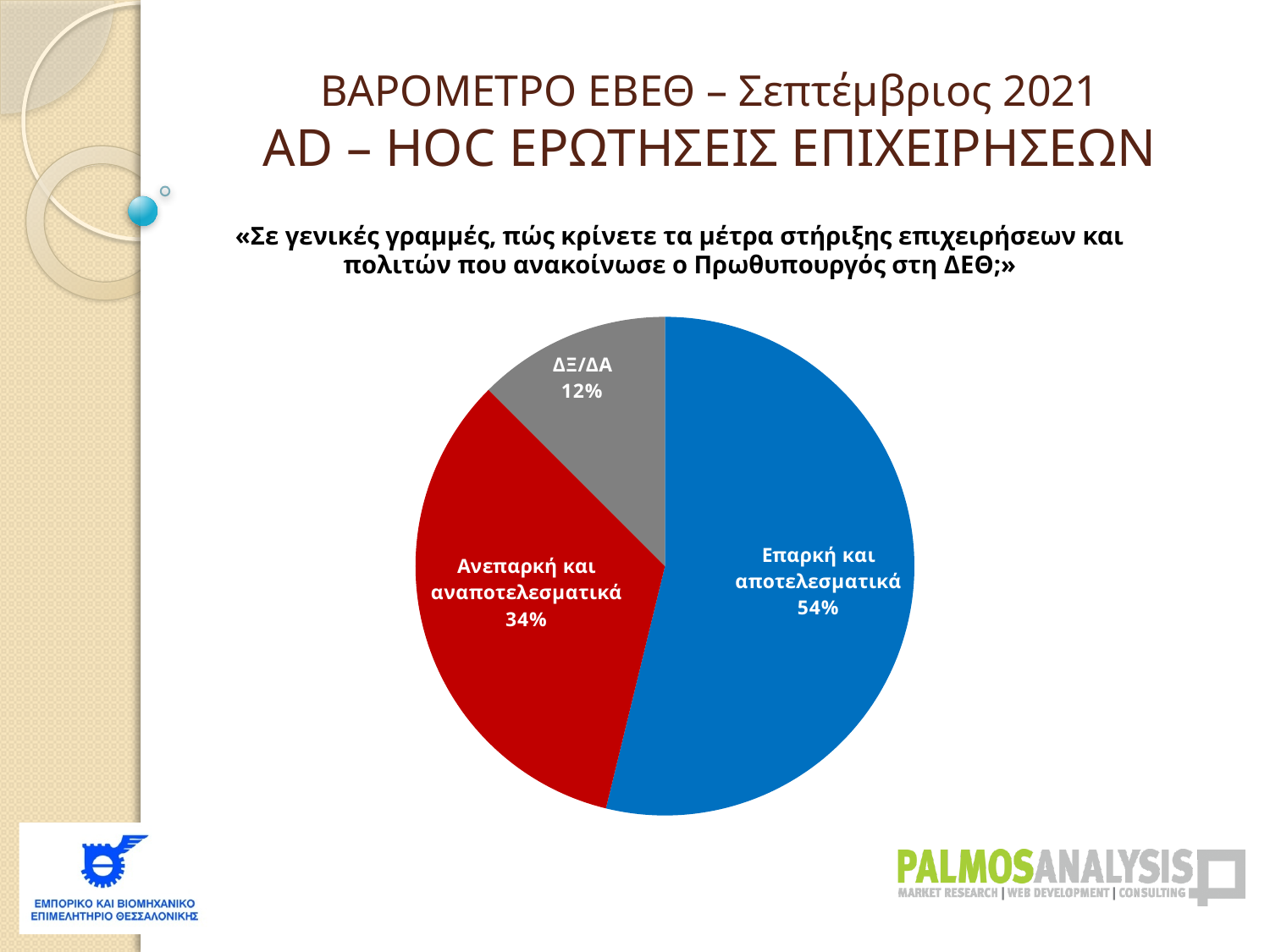
How many slices does the pie chart have? 3 What colour is the slice for «Ανεπαρκή και αναποτελεσματικά»? red What kind of chart is shown on the slide? pie chart What share of respondents answered «Ανεπαρκή και αναποτελεσματικά»? 34% Which response has the smallest slice of the pie? ΔΞ/ΔΑ Is the share for «Επαρκή και αποτελεσματικά» greater or less than 50%? greater Which is larger: the share for «Ανεπαρκή και αναποτελεσματικά» or the share for «ΔΞ/ΔΑ»? Ανεπαρκή και αναποτελεσματικά What share of respondents answered «ΔΞ/ΔΑ»? 12% What colour is the slice for «Επαρκή και αποτελεσματικά»? blue Which response has the largest slice of the pie? Επαρκή και αποτελεσματικά What share of respondents answered «Επαρκή και αποτελεσματικά»? 54% What is the difference in percentage points between «Επαρκή και αποτελεσματικά» and «Ανεπαρκή και αναποτελεσματικά»? 20 percentage points